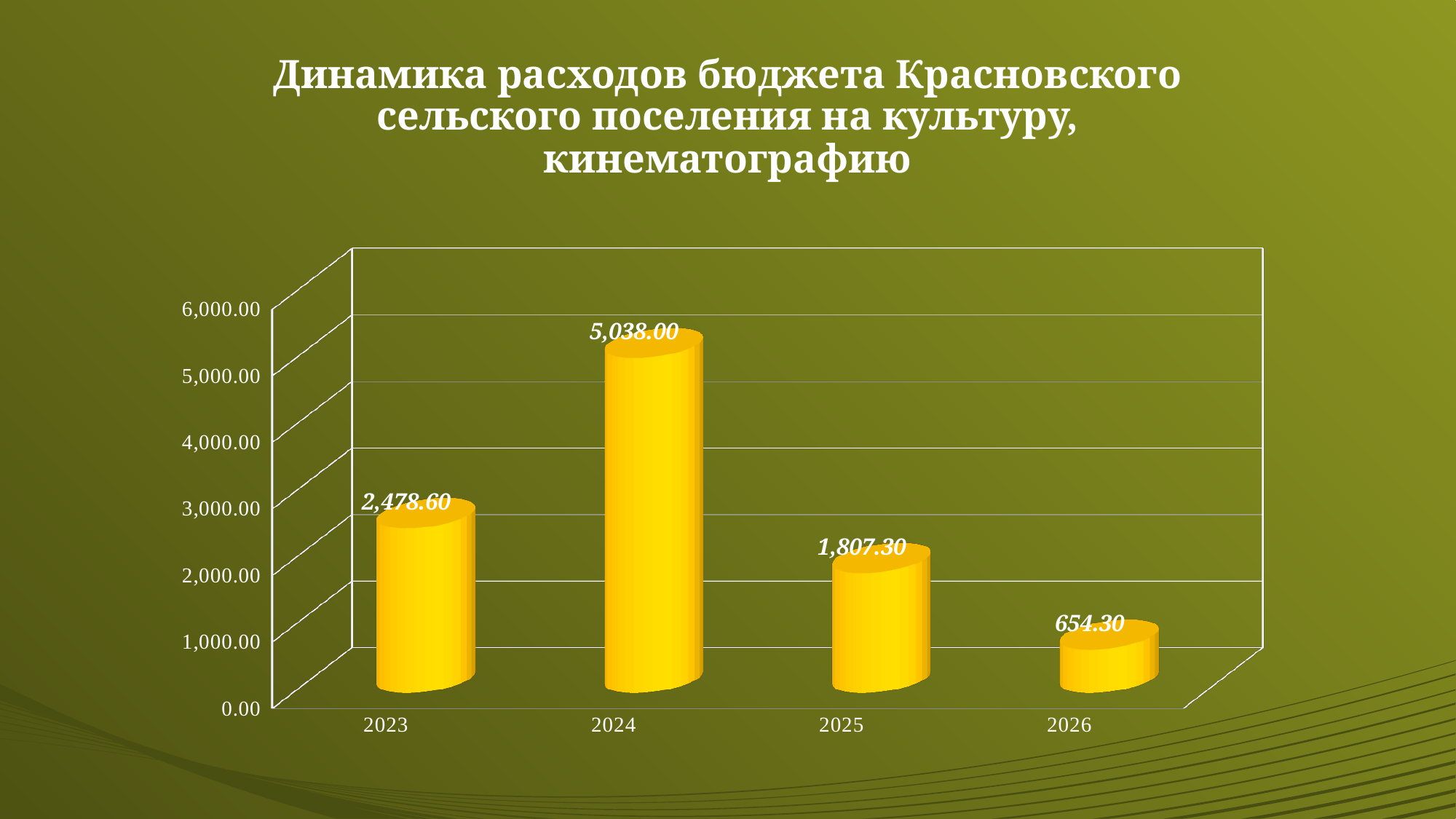
Which is larger, the value for 2023 or the value for 2025? 2023 What is the value for 2023? 2,478.60 Which year has the highest value? 2024 What is the difference between the values for 2024 and 2023? 2,559.40 Which year has the lowest value? 2026 What is the difference between the values for 2025 and 2026? 1,153.00 What is the value for 2026? 654.30 From 2024 to 2026, do the values rise or fall? Fall How many years are shown on the x axis? 4 What is the value for 2024? 5,038.00 What is the value for 2025? 1,807.30 What kind of chart is shown on the slide? Bar chart